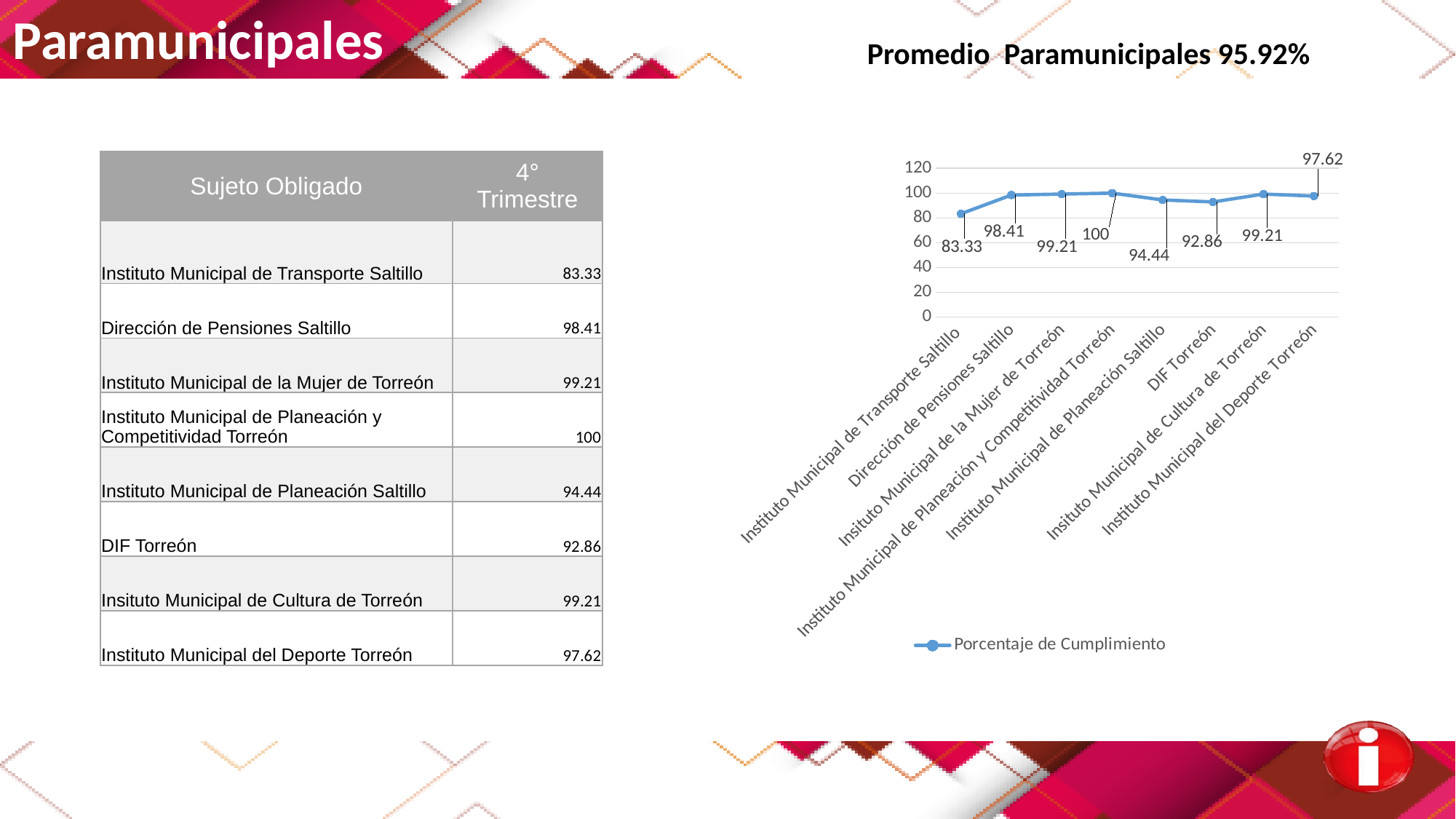
What is the value for Instituto Municipal de Transporte Saltillo? 83.33 Which category has the lowest value? Instituto Municipal de Transporte Saltillo Which is larger, the value for Instituto Municipal de Planeación Saltillo or the value for DIF Torreón? Instituto Municipal de Planeación Saltillo What is the value for DIF Torreón? 92.86 Which category has the highest value? Instituto Municipal de Planeación y Competitividad Torreón What kind of chart is shown? line chart What is the difference between the highest value (100) and the lowest value (83.33)? 16.67 Is the value for Instituto Municipal de Transporte Saltillo greater or less than 100? less What is the name of the series shown in the legend? Porcentaje de Cumplimiento How many series does the legend list? 1 What is the value for Instituto Municipal del Deporte Torreón? 97.62 How many categories are plotted on the x axis? 8